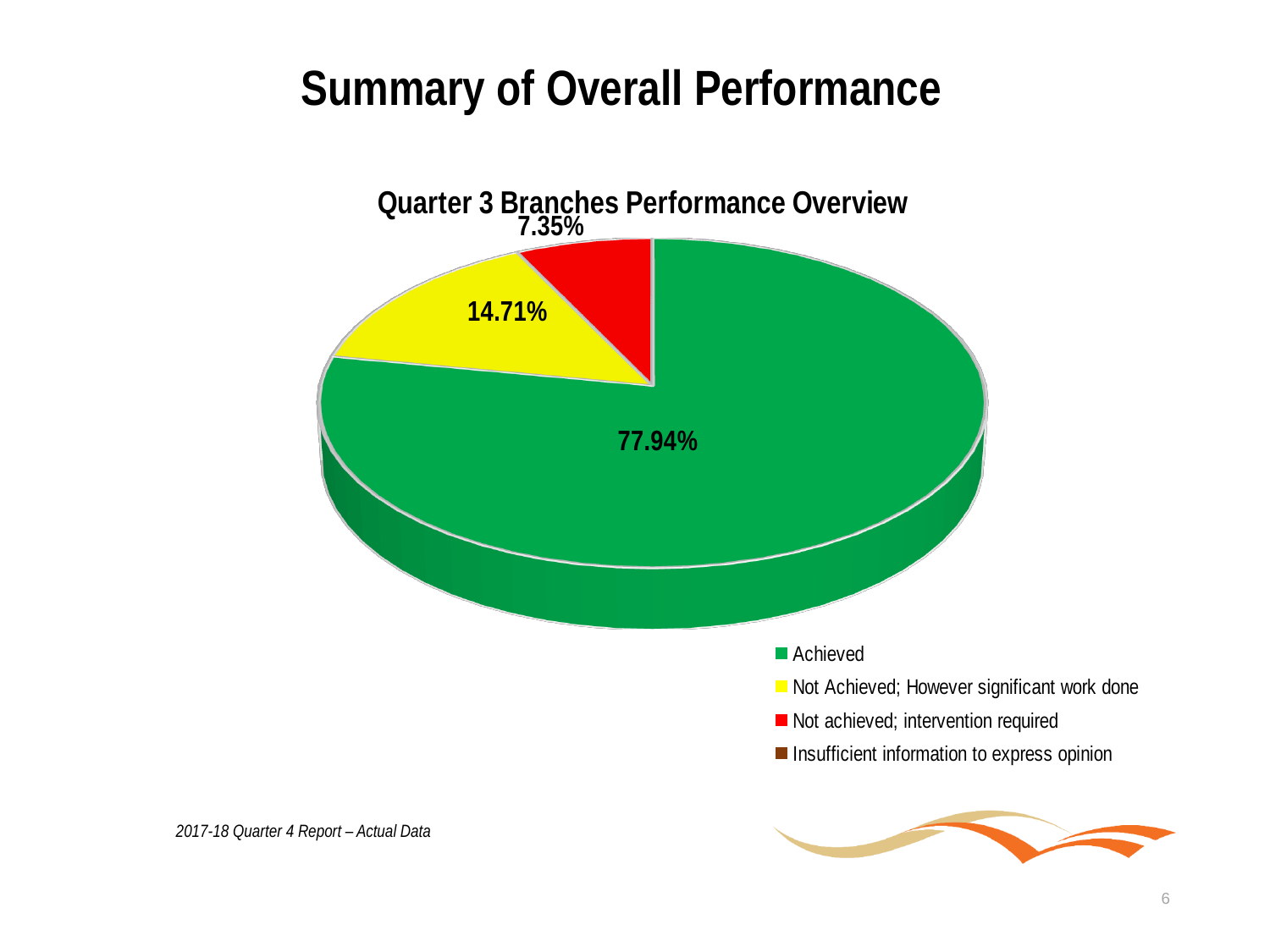
What share of the pie is labelled for the 'Not achieved; intervention required' slice? 7.35% What colour is the Achieved slice? Green What is the difference between the Achieved share and the 'Not Achieved; However significant work done' share? 63.23% What is the chart's title? Quarter 3 Branches Performance Overview Which is larger: the 'Not Achieved; However significant work done' slice or the 'Not achieved; intervention required' slice? Not Achieved; However significant work done What share of the pie is labelled for the 'Not Achieved; However significant work done' slice? 14.71% Which category has the largest slice of the pie? Achieved How many slices are visible in the pie? 3 What kind of chart is shown on the slide? Pie chart How many entries does the legend list? 4 What share of the pie is labelled for the Achieved slice? 77.94% Which of the labelled slices is the smallest? Not achieved; intervention required